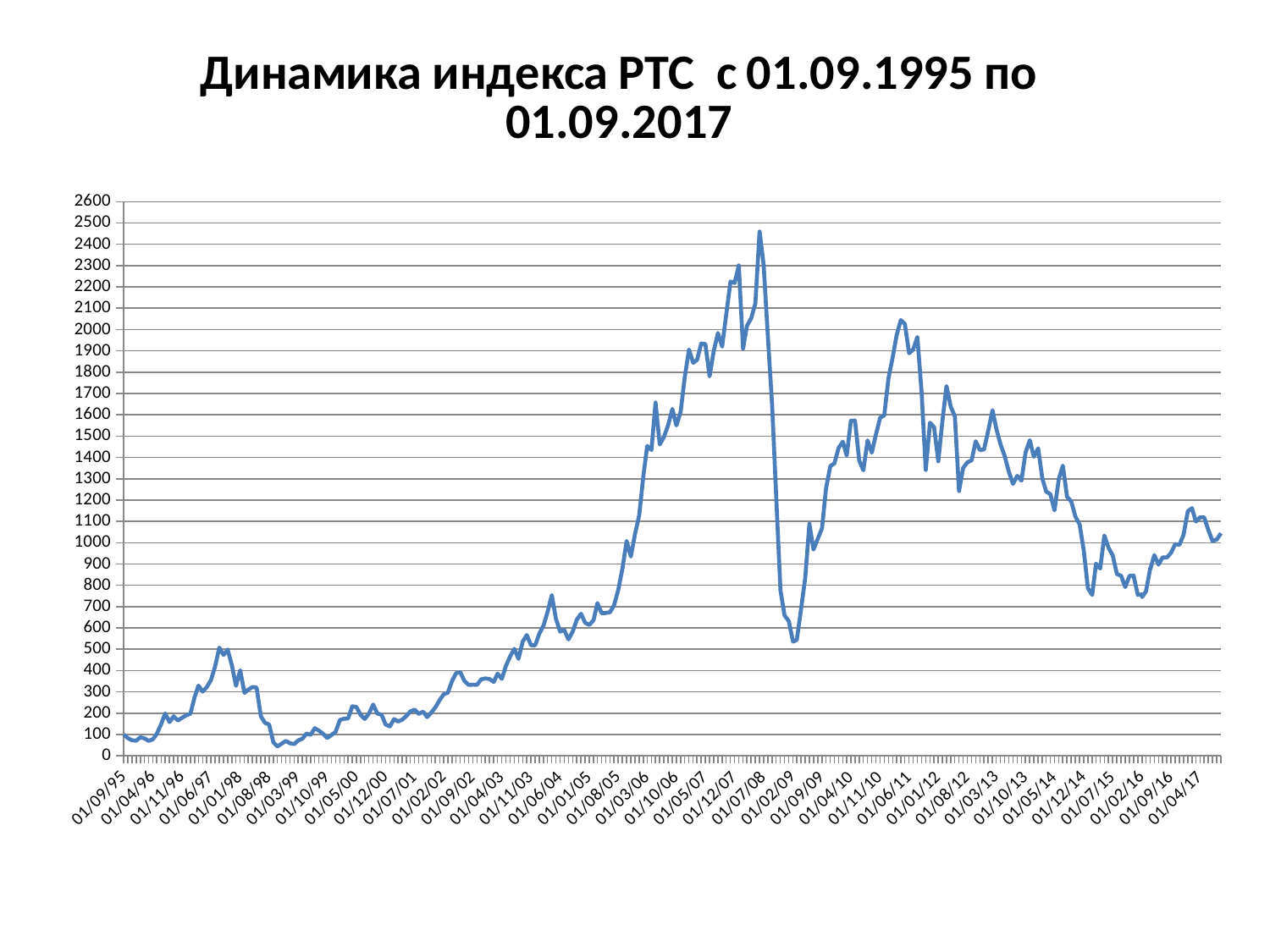
Does the index rise or fall between 01/03/99 and 01/07/08? rise Is the value of the index at 01/04/17 greater or less than 900? greater What is the highest value shown on the vertical axis? 2600 Is the peak value of the index greater or less than 2500? less How many data series are plotted on the chart? 1 What is the title of the chart? Динамика индекса РТС с 01.09.1995 по 01.09.2017 What kind of chart is shown on the slide? line chart Does the index rise or fall between 01/07/08 and 01/02/09? fall Is the value of the index at 01/02/09 greater or less than 700? less Which is larger, the index value at 01/06/11 or at 01/04/17? 01/06/11